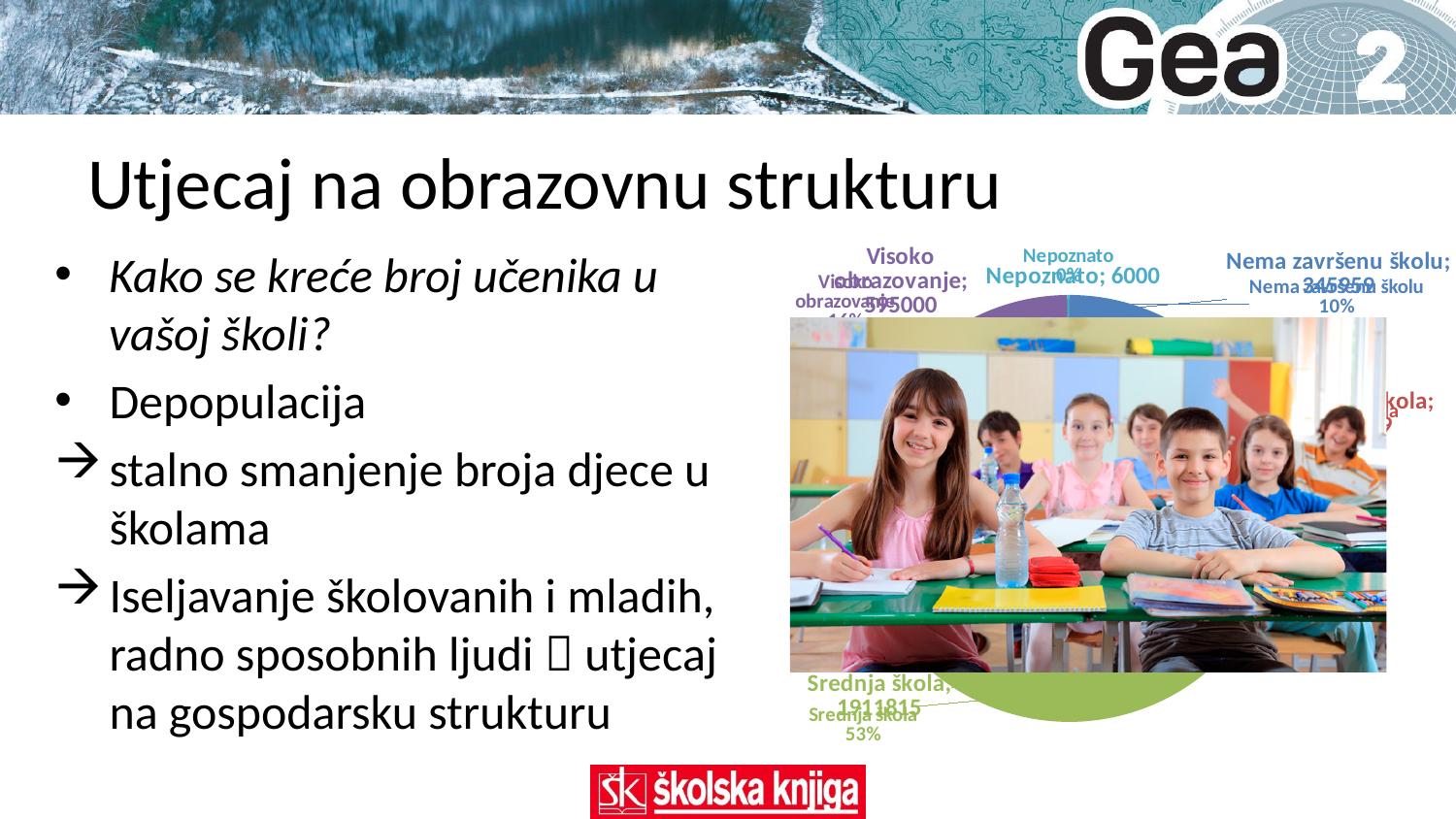
What is the value for Nepoznato in the pie chart? 6000 What is the difference between the values for Srednja škola and Nema završenu školu? 1565856 What is the difference between the values for Nema završenu školu and Nepoznato? 339959 What is the value for Visoko obrazovanje in the pie chart? 595000 What is the value for Srednja škola in the pie chart? 1911815 What share of the pie does Srednja škola represent? 53% What is the value for Nema završenu školu in the pie chart? 345959 Which is larger, Nema završenu školu or Nepoznato? Nema završenu školu What kind of chart is shown on the slide? pie chart Which category has the largest slice in the pie chart? Srednja škola What share of the pie does Nepoznato represent? 0% What share of the pie does Nema završenu školu represent? 10%